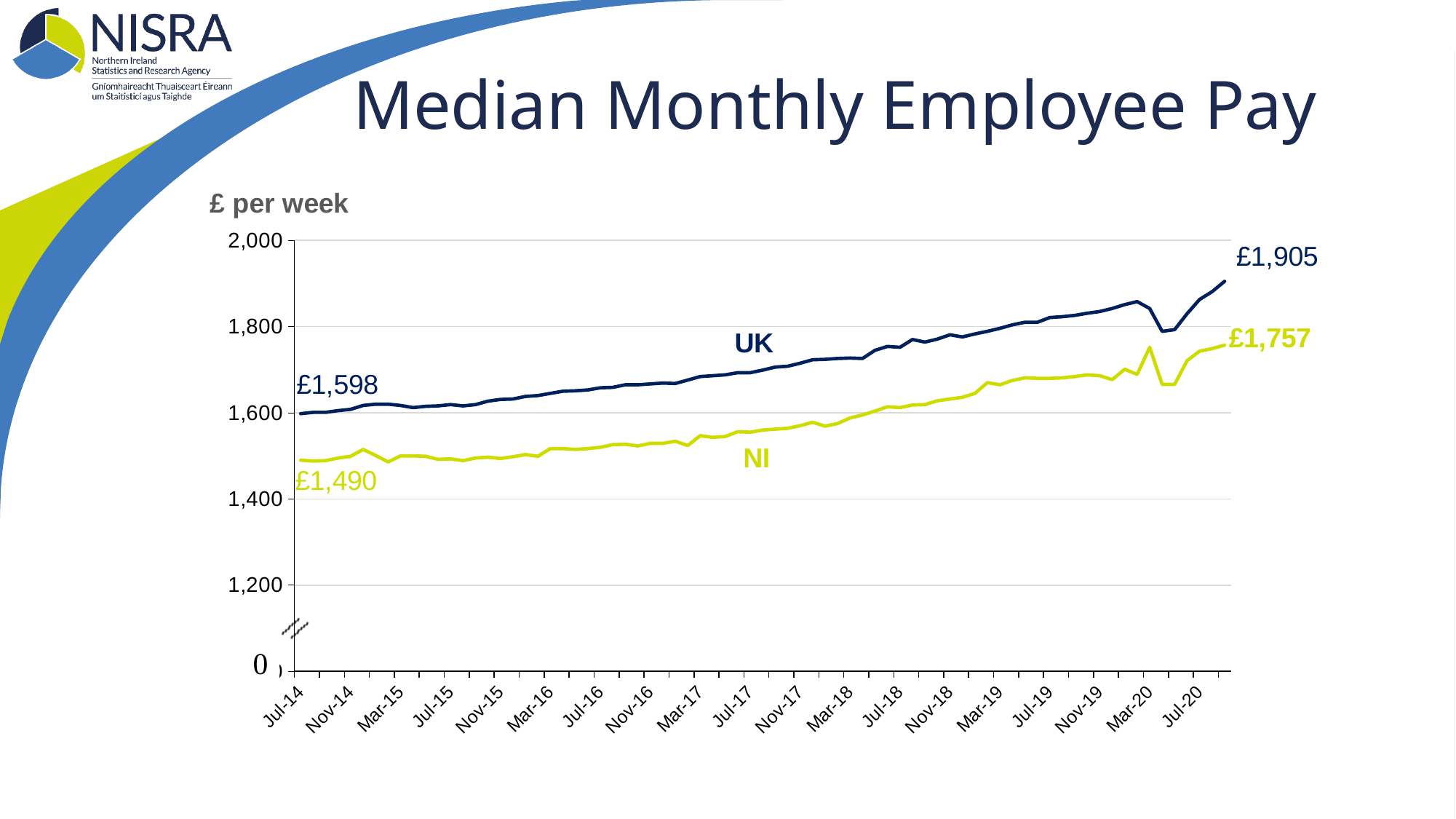
Which series has the higher value at the end of the chart, UK or NI? UK Overall, do the UK and NI values rise or fall from Jul-14 to the end of the chart? Rise What is the labelled value for the UK series at the end of the chart? £1,905 By how much did the UK value increase from its labelled start value to its labelled end value? £307 How many series are plotted on the chart? 2 What is the labelled value for the UK series at the start of the chart (Jul-14)? £1,598 What is the difference between the UK and NI labelled values at the end of the chart? £148 What is the labelled value for the NI series at the end of the chart? £1,757 What kind of chart is shown on the slide? Line chart Is the value for the UK series at Jul-16 greater or less than 1,800? less What is the labelled value for the NI series at the start of the chart (Jul-14)? £1,490 By how much did the NI value increase from its labelled start value to its labelled end value? £267